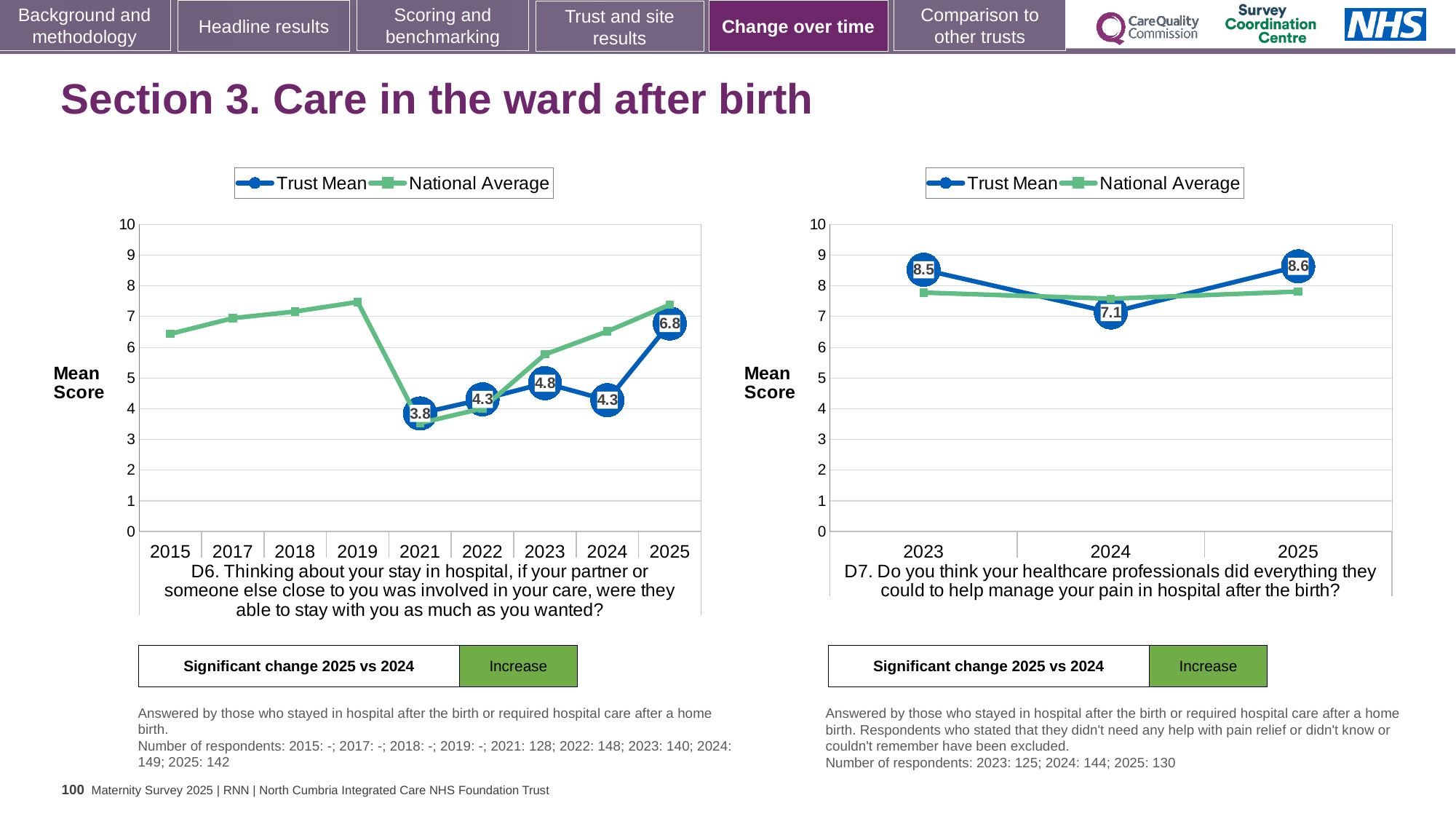
What type of chart is the D7 chart (right)? line chart How many years are shown on the x axis of the D7 chart (right)? 3 On the D7 chart (right), which year has the highest Trust Mean score? 2025 On the D7 chart (right), what is the difference between the Trust Mean scores for 2023 and 2024? 1.4 On the D6 chart (left), what is the difference between the Trust Mean scores for 2025 and 2024? 2.5 On the D6 chart (left), which year has the lowest Trust Mean score? 2021 On the D6 chart (left), is the National Average for 2019 greater or less than 7? greater On the D6 chart (left), is the Trust Mean score for 2023 higher or lower than for 2024? higher On the D6 chart (left), what is the Trust Mean score for 2025? 6.8 On the D7 chart (right), what is the Trust Mean score for 2024? 7.1 On the D6 chart (left), what is the Trust Mean score for 2021? 3.8 How many series does the legend of the D6 chart (left) list? 2